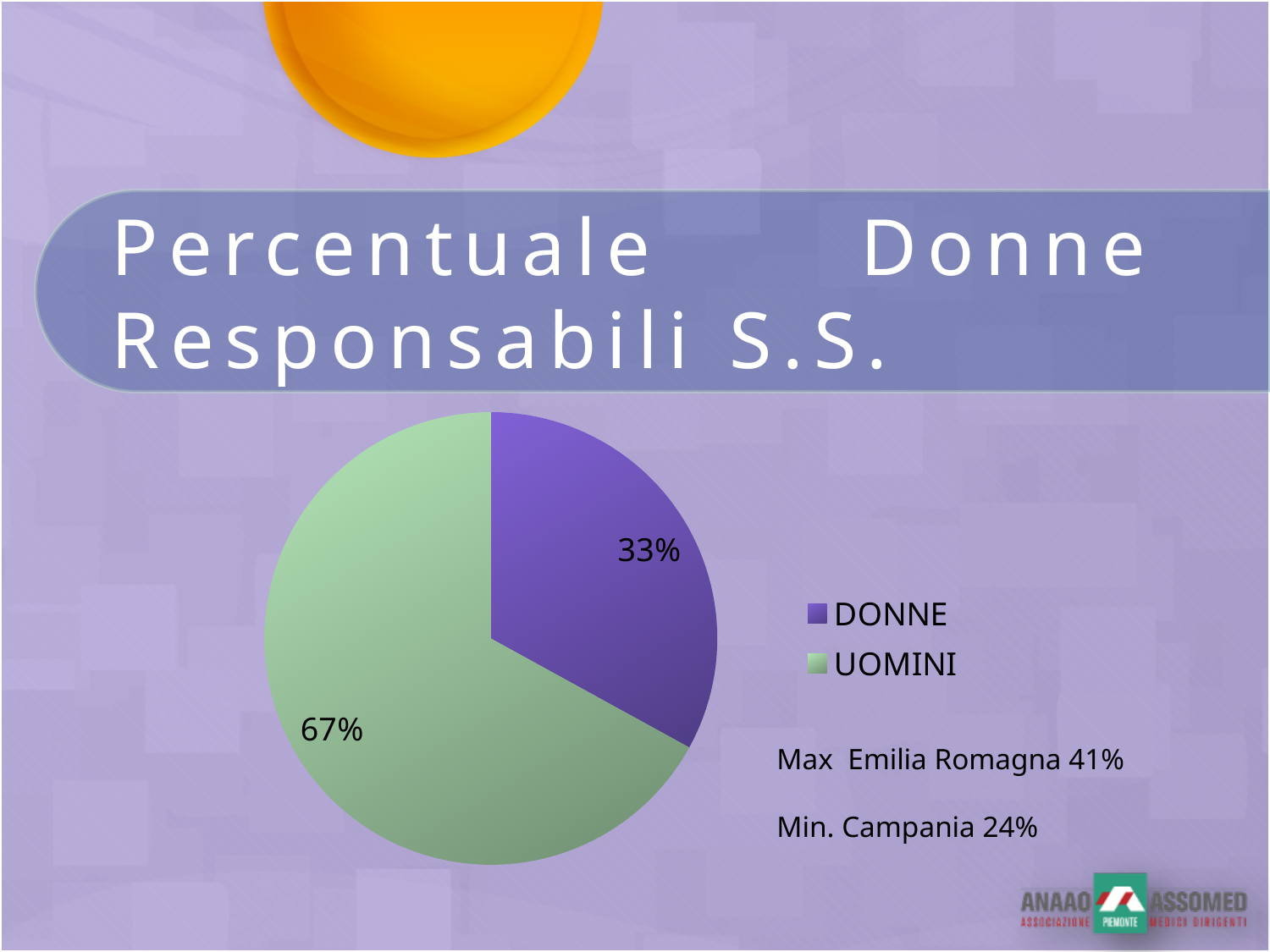
What percentage of the pie chart is labelled UOMINI? 67% How many entries does the legend of the pie chart list? 2 Which slice of the pie chart is the largest? UOMINI What is the title of the slide containing the pie chart? Percentuale Donne Responsabili S.S. Which slice is larger, DONNE or UOMINI? UOMINI What is the share of the pie taken by the DONNE slice? 33% Which slice of the pie chart is the smallest? DONNE What percentage of the pie chart is labelled DONNE? 33% How many slices does the pie chart have? 2 What is the difference in percentage points between the UOMINI slice and the DONNE slice? 34 What colour is the DONNE slice in the pie chart? purple What kind of chart is shown on the slide? pie chart